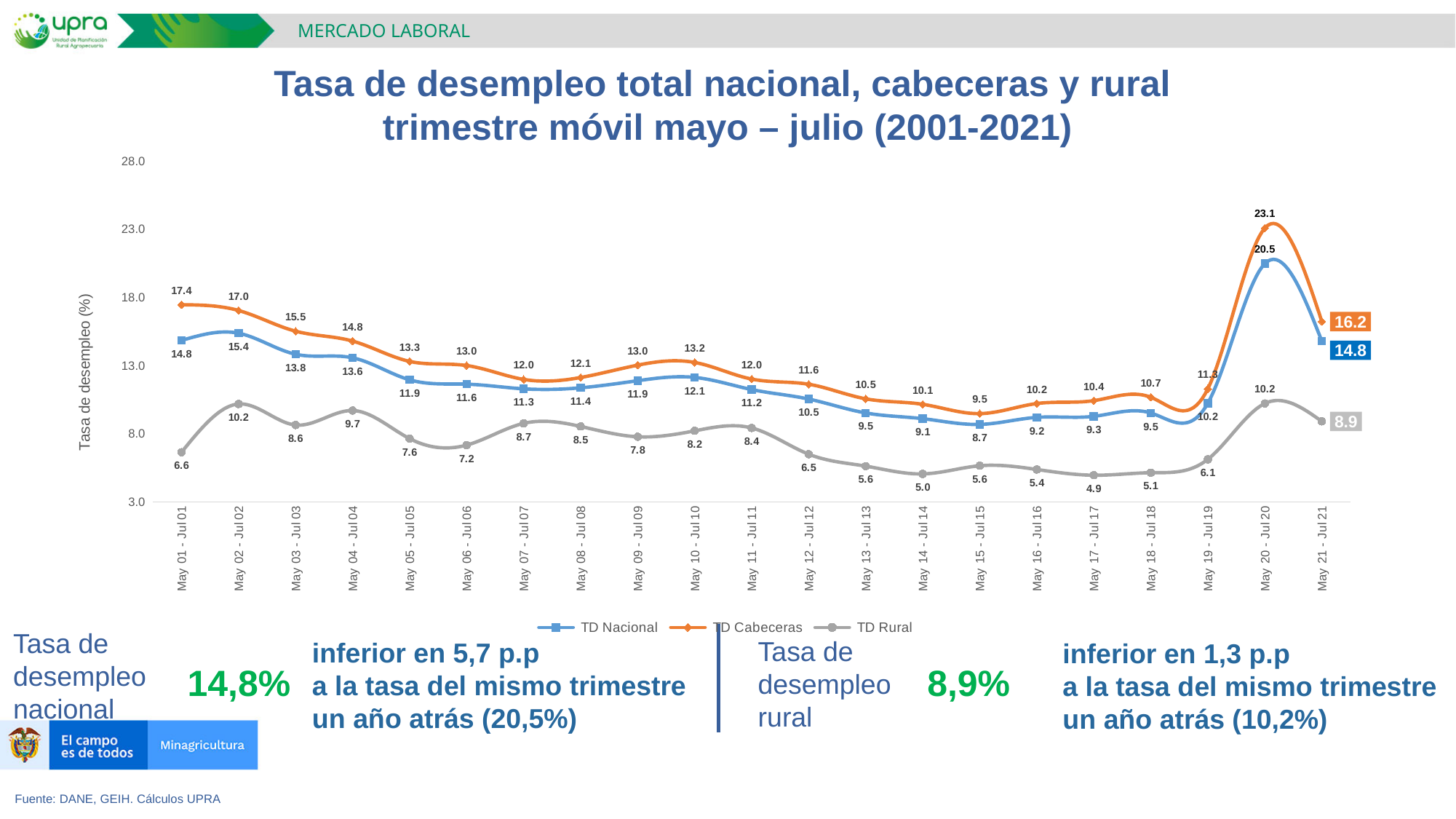
How many periods are plotted along the x axis? 21 What is the value of TD Rural for May 21 - Jul 21? 8.9 What is the value of TD Nacional for May 15 - Jul 15? 8.7 In which period does TD Nacional reach its highest value? May 20 - Jul 20 Which is larger for TD Rural: the value in May 02 - Jul 02 or in May 21 - Jul 21? May 02 - Jul 02 In which period does TD Rural reach its lowest value? May 17 - Jul 17 Does TD Cabeceras rise or fall from May 01 - Jul 01 to May 07 - Jul 07? fall How many series does the legend list? 3 By how much did TD Nacional fall from May 20 - Jul 20 to May 21 - Jul 21? 5.7 What is the difference between TD Cabeceras and TD Nacional in May 21 - Jul 21? 1.4 What is the value of TD Cabeceras for May 20 - Jul 20? 23.1 What kind of chart is shown on the slide? line chart